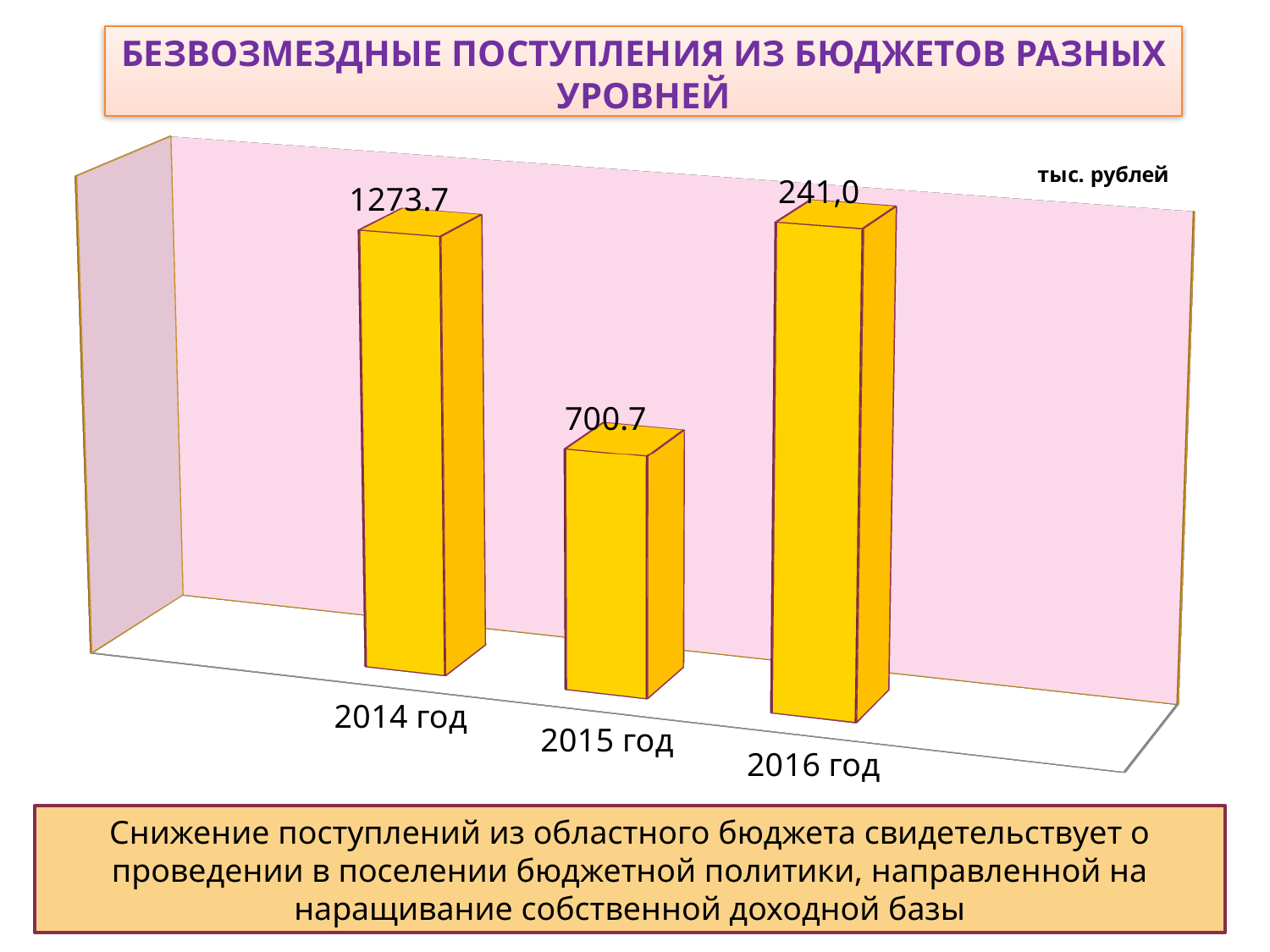
Which is larger, the value for 2014 год or the value for 2015 год? 2014 год What is the difference between the values for 2014 год and 2015 год? 573.0 How many categories (years) are shown in the chart? 3 What is the value for 2014 год? 1273.7 What kind of chart is shown on the slide? Bar chart What is the title of the chart? БЕЗВОЗМЕЗДНЫЕ ПОСТУПЛЕНИЯ ИЗ БЮДЖЕТОВ РАЗНЫХ УРОВНЕЙ What is the value for 2015 год? 700.7 What unit of measurement is indicated on the chart? тыс. рублей